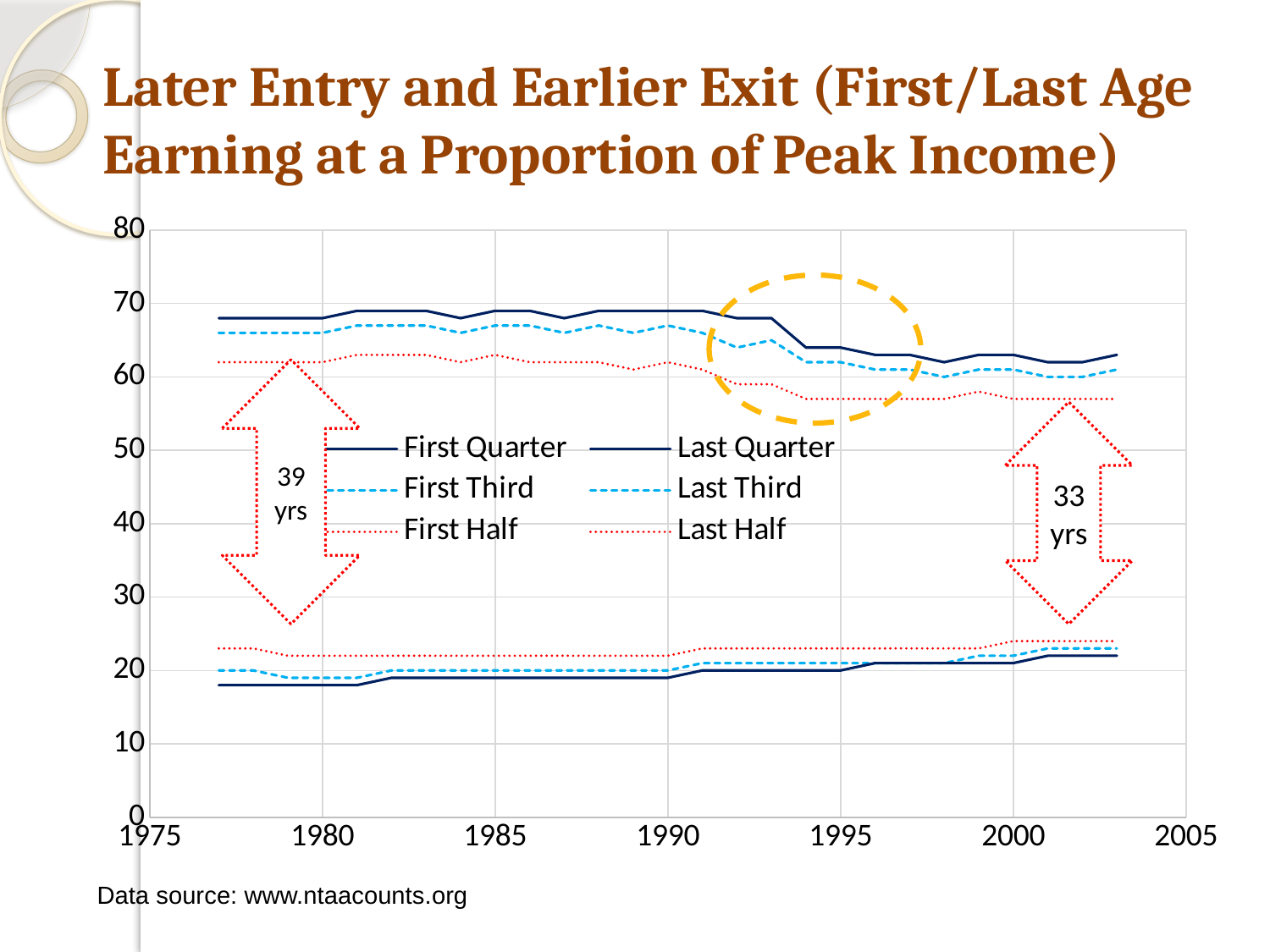
Is the value for Last Quarter in 1980 greater or less than 60? greater What span in years does the left arrow annotation on the chart indicate? 39 yrs How many series does the legend list? 6 What kind of chart is shown on the slide? Line chart Does the Last Quarter line rise or fall from 1977 to 2003? Fall Which is lower in 1985, First Quarter or First Half? First Quarter Which series has the highest values across the chart? Last Quarter Is the value for First Quarter in 1980 greater or less than 20? less Is the value for Last Half in 2000 greater or less than 60? less Which is higher in 1985, Last Quarter or Last Half? Last Quarter Does the First Quarter line rise or fall from 1977 to 2003? Rise